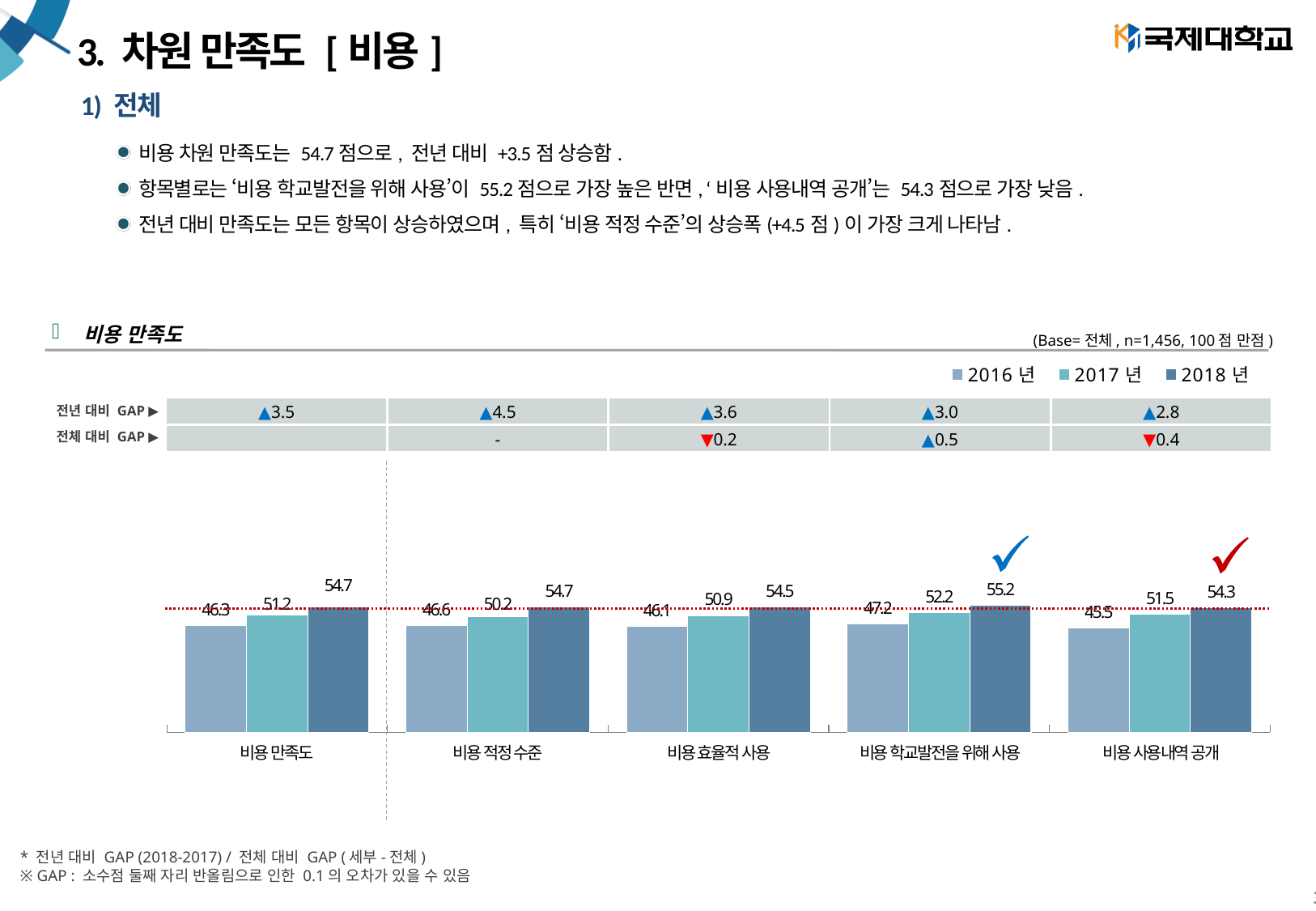
What is the 전년 대비 GAP shown for 비용 효율적 사용? ▲3.6 Which category has the lowest 2016년 value? 비용 사용내역 공개 Do the values for 비용 만족도 rise or fall from 2016년 to 2018년? rise How many categories are shown along the x axis of the chart? 5 Which category has the highest 2018년 value? 비용 학교발전을 위해 사용 Which is larger for 비용 사용내역 공개: the 2017년 value or the 2018년 value? 2018년 What is the difference between the 2018년 and 2017년 values for 비용 적정 수준? 4.5 How many series does the chart legend list? 3 What is the 2017년 value for 비용 효율적 사용? 50.9 What type of chart is shown on the slide? bar chart What is the 2016년 value for 비용 사용내역 공개? 45.5 What is the 2018년 value for 비용 학교발전을 위해 사용? 55.2